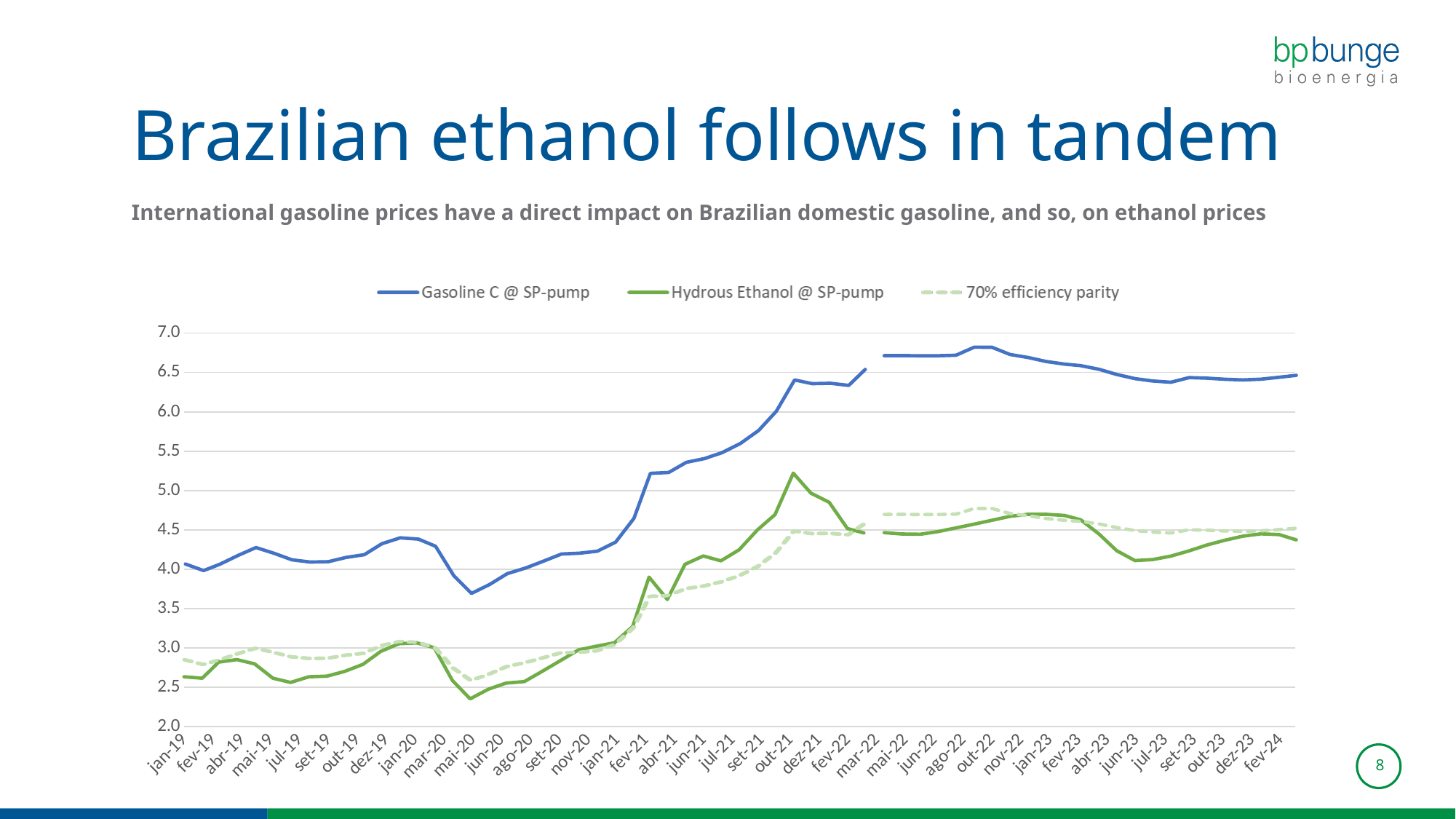
In which month does Hydrous Ethanol @ SP-pump reach its lowest value? mai-20 Is the value for Hydrous Ethanol @ SP-pump in jun-23 greater or less than 4.5? less In mai-20, which is higher, Hydrous Ethanol @ SP-pump or 70% efficiency parity? 70% efficiency parity What kind of chart is shown on the slide? line chart How many series does the legend list? 3 Which series is drawn with a dashed line? 70% efficiency parity In jan-19, which series has the higher value, Gasoline C @ SP-pump or Hydrous Ethanol @ SP-pump? Gasoline C @ SP-pump Is the value for Gasoline C @ SP-pump in mai-20 greater or less than 4.0? less Is the value for Hydrous Ethanol @ SP-pump in out-21 greater or less than 5.0? less Which series is drawn in blue? Gasoline C @ SP-pump